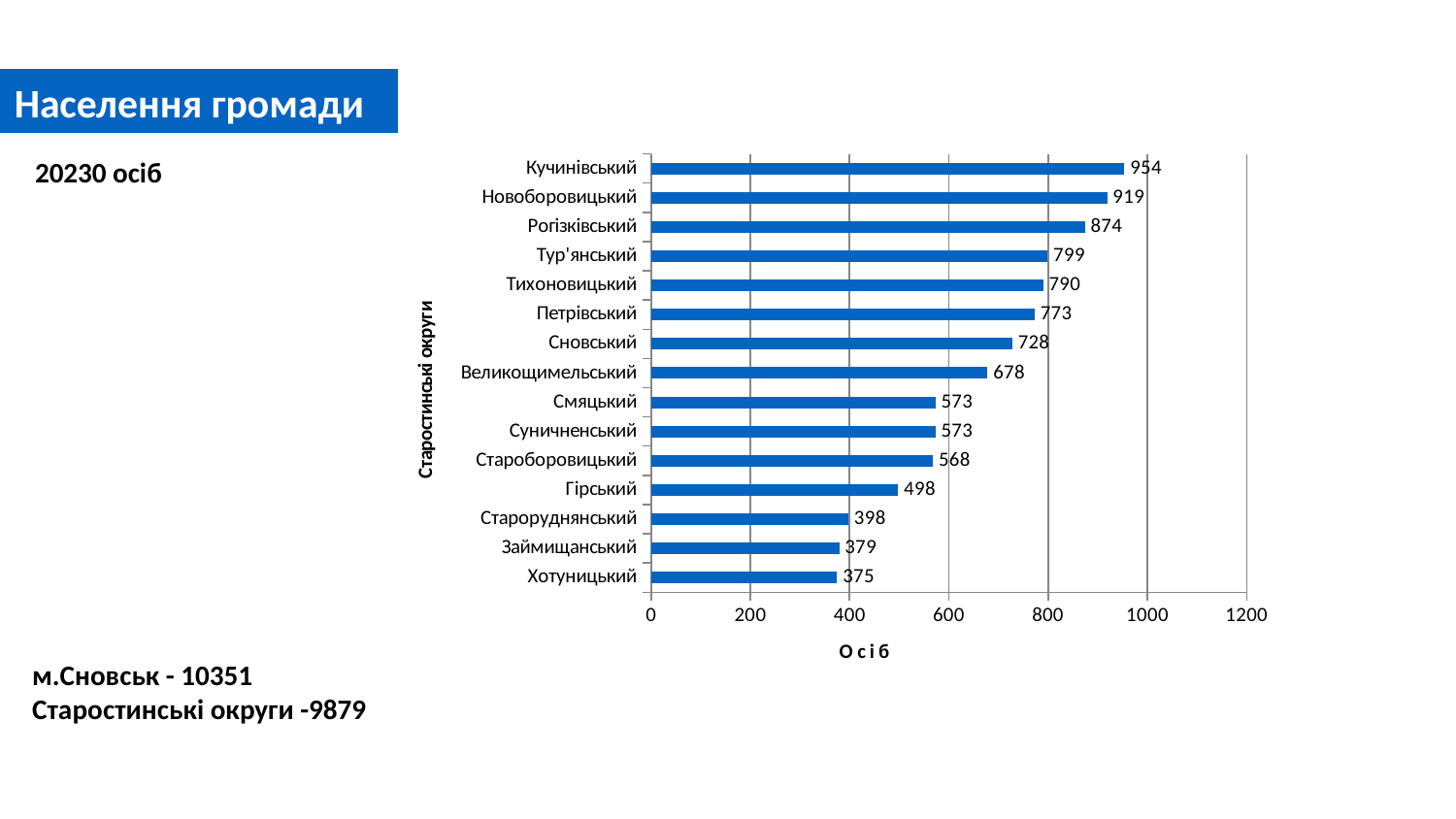
What kind of chart is shown on the slide? bar chart Which category has the lowest value? Хотуницький Which is larger, the value for Петрівський or the value for Сновський? Петрівський How many categories are shown on the chart? 15 What is the value for Великощимельський? 678 What is the value for Кучинівський? 954 What is the title of the horizontal axis? Осіб Which category has the highest value? Кучинівський What is the difference between the values for Кучинівський and Хотуницький? 579 What is the difference between the values for Новоборовицький and Рогізківський? 45 What is the value for Старорудянський? 398 Is the value for Гірський greater or less than 600? less